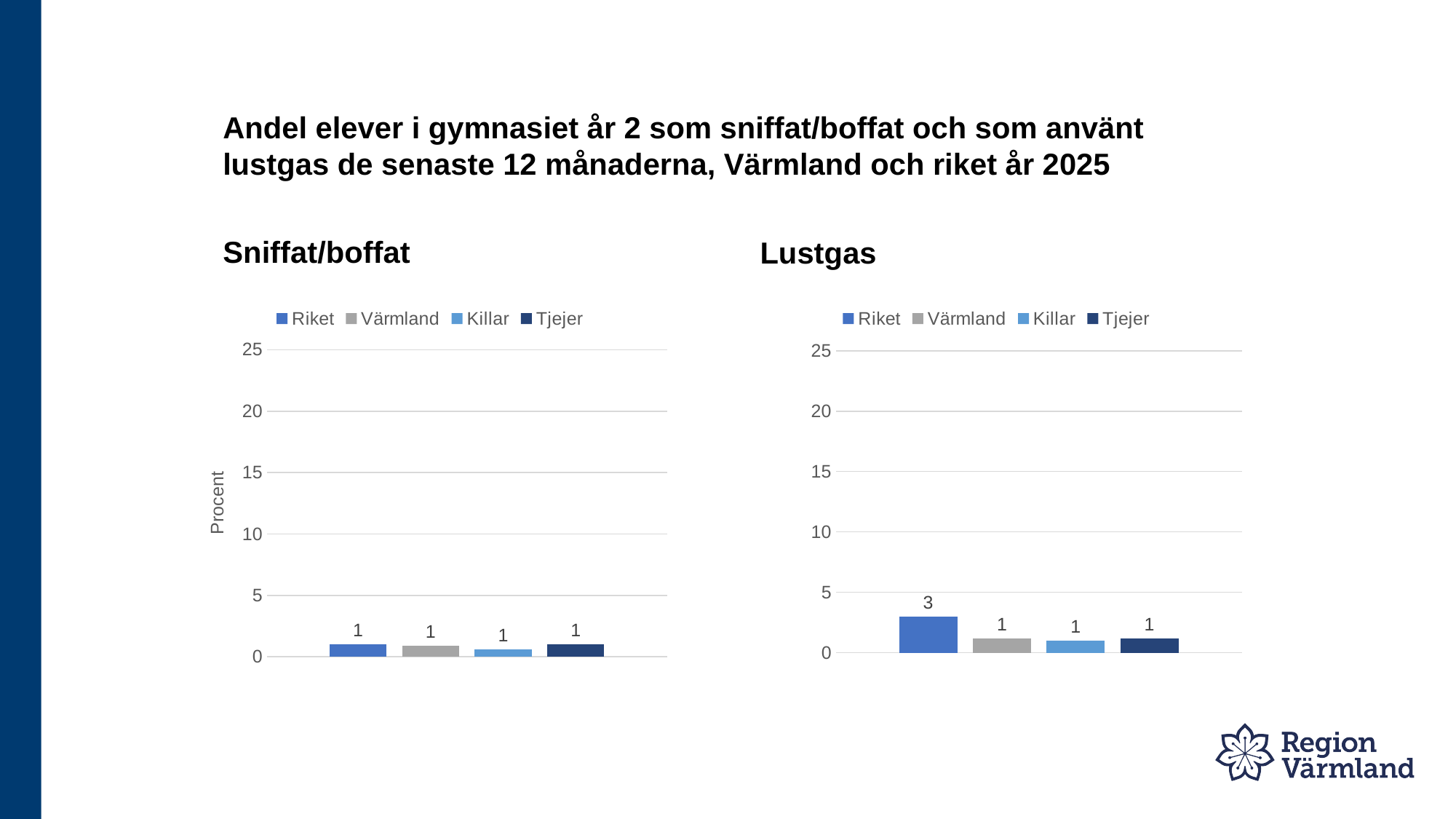
How many bars are plotted in the Sniffat/boffat chart? 4 In the Lustgas chart, which series has the highest value? Riket What is the label on the vertical axis of the Sniffat/boffat chart? Procent In the Lustgas chart, is the value for Riket greater or less than 5? less In the Lustgas chart, what is the value for Värmland? 1 In the Lustgas chart, what is the value for Riket? 3 In the Lustgas chart, what is the difference between the values for Riket and Killar? 2 In the Sniffat/boffat chart, what is the value for Tjejer? 1 How many series does the legend of the Sniffat/boffat chart list? 4 What is the highest tick value shown on the vertical axis of the Lustgas chart? 25 Which is larger: the value for Riket in the Lustgas chart or the value for Riket in the Sniffat/boffat chart? Riket in the Lustgas chart What kind of chart is the Lustgas chart? bar chart